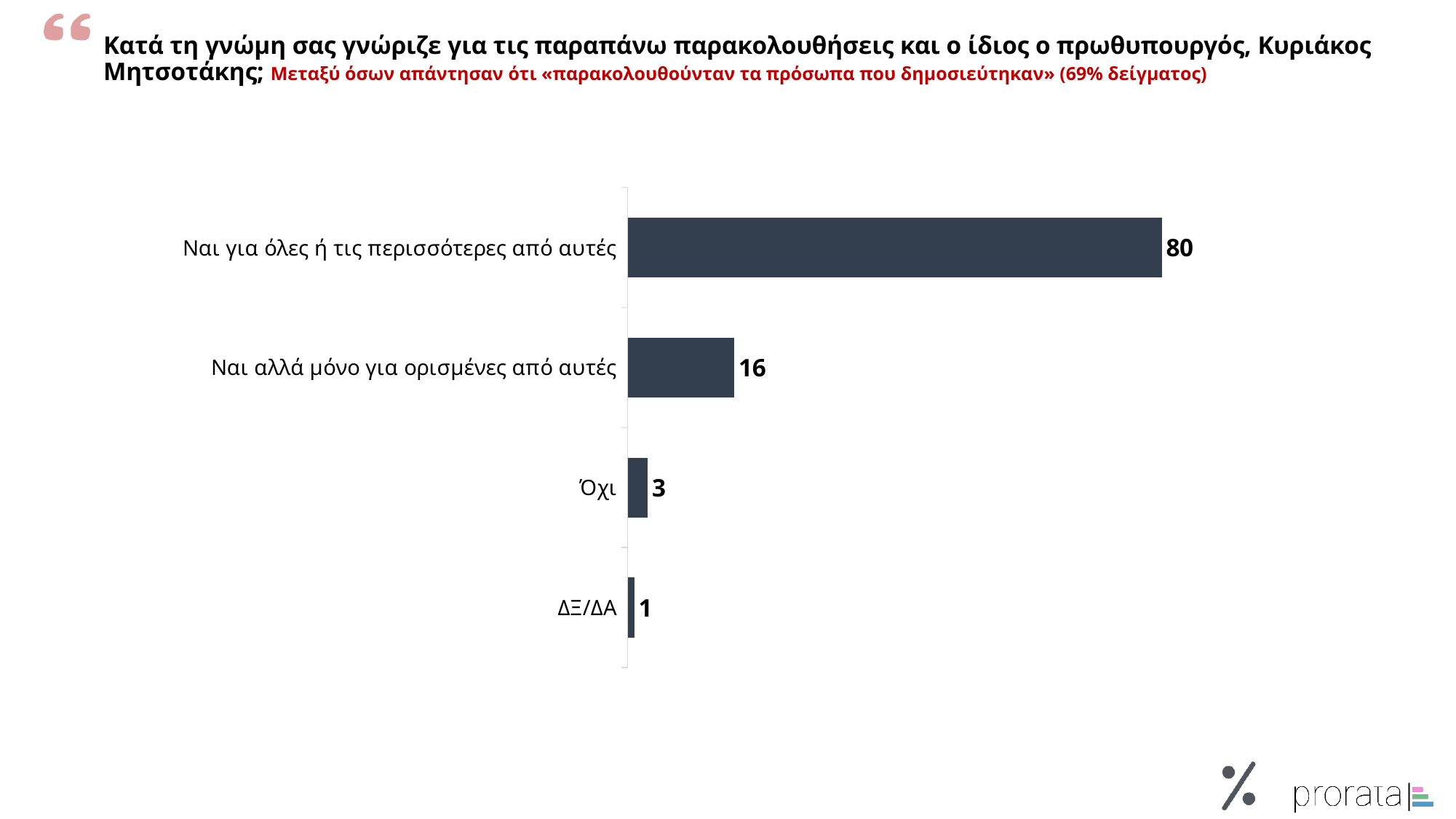
Which category has the lowest value? ΔΞ/ΔΑ What is the value for "Ναι αλλά μόνο για ορισμένες από αυτές"? 16 What kind of chart is shown on the slide? Bar chart Which category has the highest value? Ναι για όλες ή τις περισσότερες από αυτές What is the difference between the values for "Όχι" and "ΔΞ/ΔΑ"? 2 What is the difference between the values for "Ναι για όλες ή τις περισσότερες από αυτές" and "Ναι αλλά μόνο για ορισμένες από αυτές"? 64 What is the value for "ΔΞ/ΔΑ"? 1 What is the value for "Ναι για όλες ή τις περισσότερες από αυτές"? 80 What percentage of the sample does the red subtitle say answered that the published persons were being monitored? 69% How many categories are shown in the chart? 4 Which is larger, the value for "Ναι αλλά μόνο για ορισμένες από αυτές" or the value for "Όχι"? Ναι αλλά μόνο για ορισμένες από αυτές What is the value for "Όχι"? 3